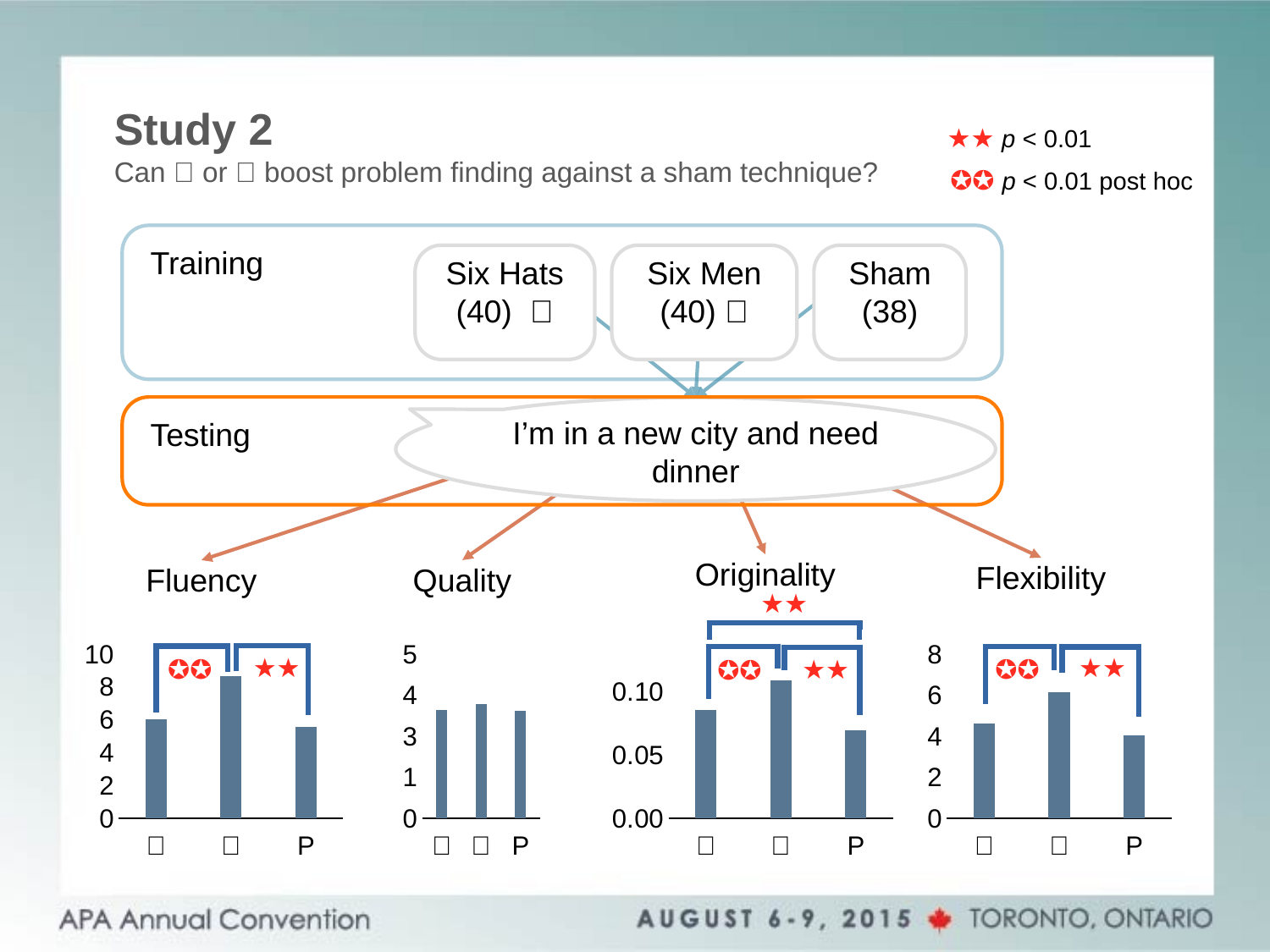
What is the highest tick value on the y axis of the Originality chart? 0.10 In the Fluency chart, is the value for P greater or less than 8? less How many bar charts are shown on the slide? 4 In the Fluency chart, is the value for P greater or less than 4? greater In the Flexibility chart, is the value for P greater or less than 2? greater How many bars does the Fluency chart show? 3 What kind of chart is the Fluency chart? bar chart How many bars does the Originality chart show? 3